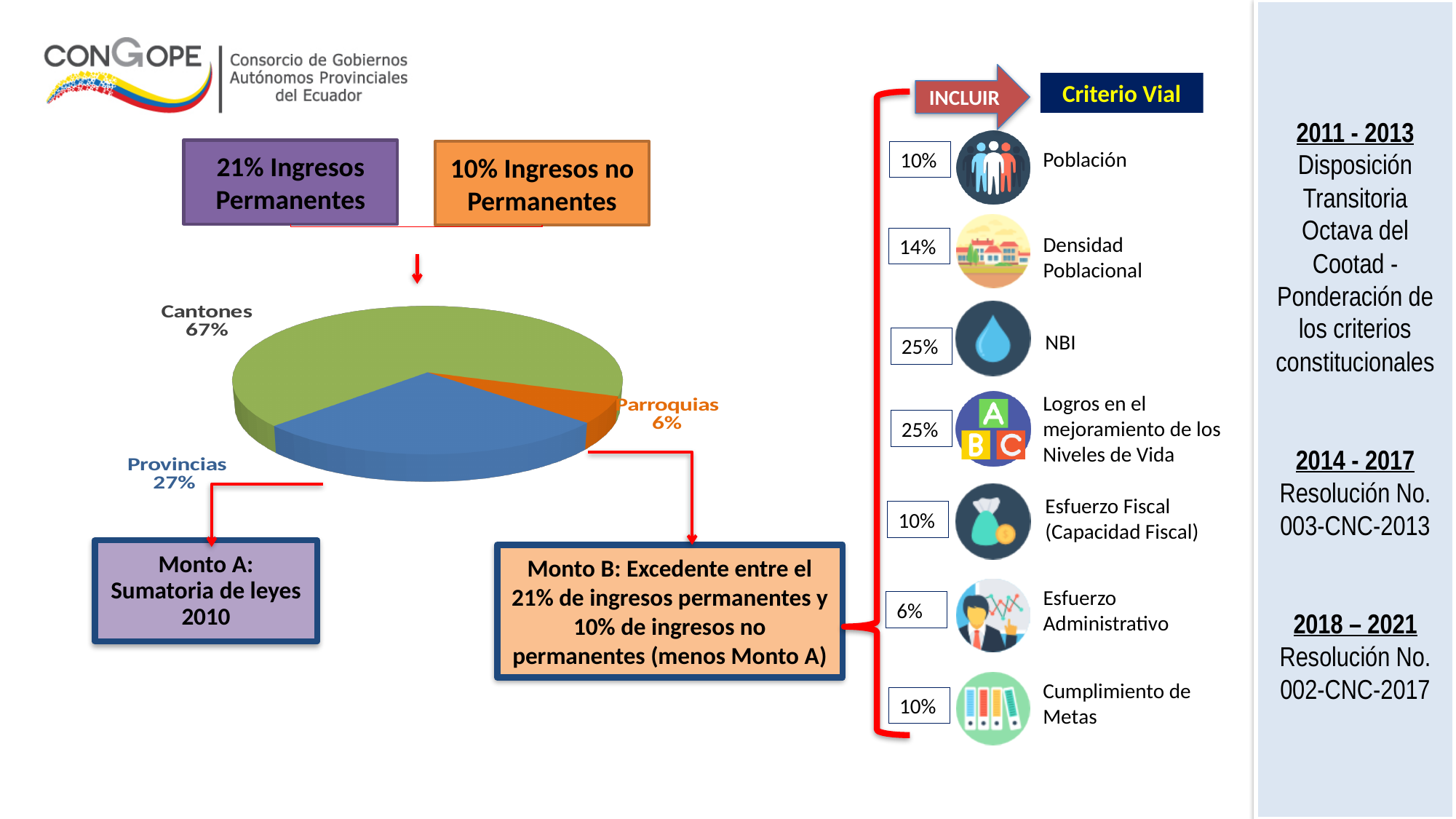
Which slice is larger, Provincias or Parroquias? Provincias What colour is the Provincias slice of the pie? blue Which category has the smallest slice of the pie? Parroquias What colour is the Cantones slice of the pie? green What is the difference in percentage points between the Cantones and Provincias slices? 40 What kind of chart is shown on the slide? pie chart How many slices does the pie chart have? 3 What share of the pie does Parroquias represent? 6% What is the difference in percentage points between the Provincias and Parroquias slices? 21 What share of the pie does Cantones represent? 67% Which category has the largest slice of the pie? Cantones What share of the pie does Provincias represent? 27%